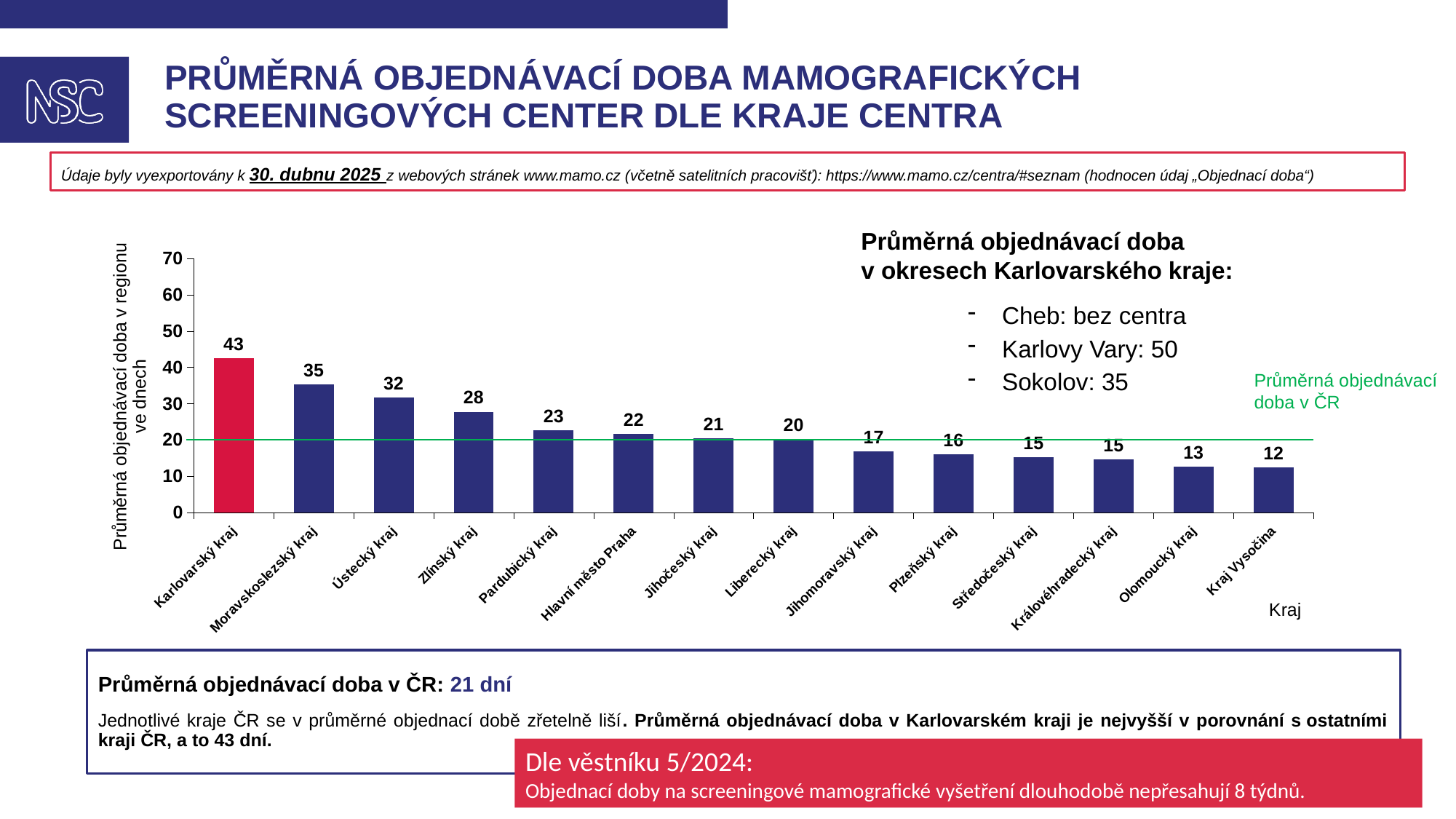
What type of chart is shown on the slide? bar chart Do the bar values rise or fall from left to right along the x axis? fall Which region has the highest bar in the chart? Karlovarský kraj What is the difference between the values for Karlovarský kraj and Moravskoslezský kraj? 8 What value is shown for Zlínský kraj? 28 Is the value for Jihomoravský kraj greater or less than 20? less What does the green horizontal line in the chart represent? Průměrná objednávací doba v ČR What value is shown for Hlavní město Praha? 22 How many regions (bars) are shown in the chart? 14 What is the average ordering time shown for Karlovarský kraj? 43 Which region has the lowest bar in the chart? Kraj Vysočina Which has a larger value, Ústecký kraj or Pardubický kraj? Ústecký kraj